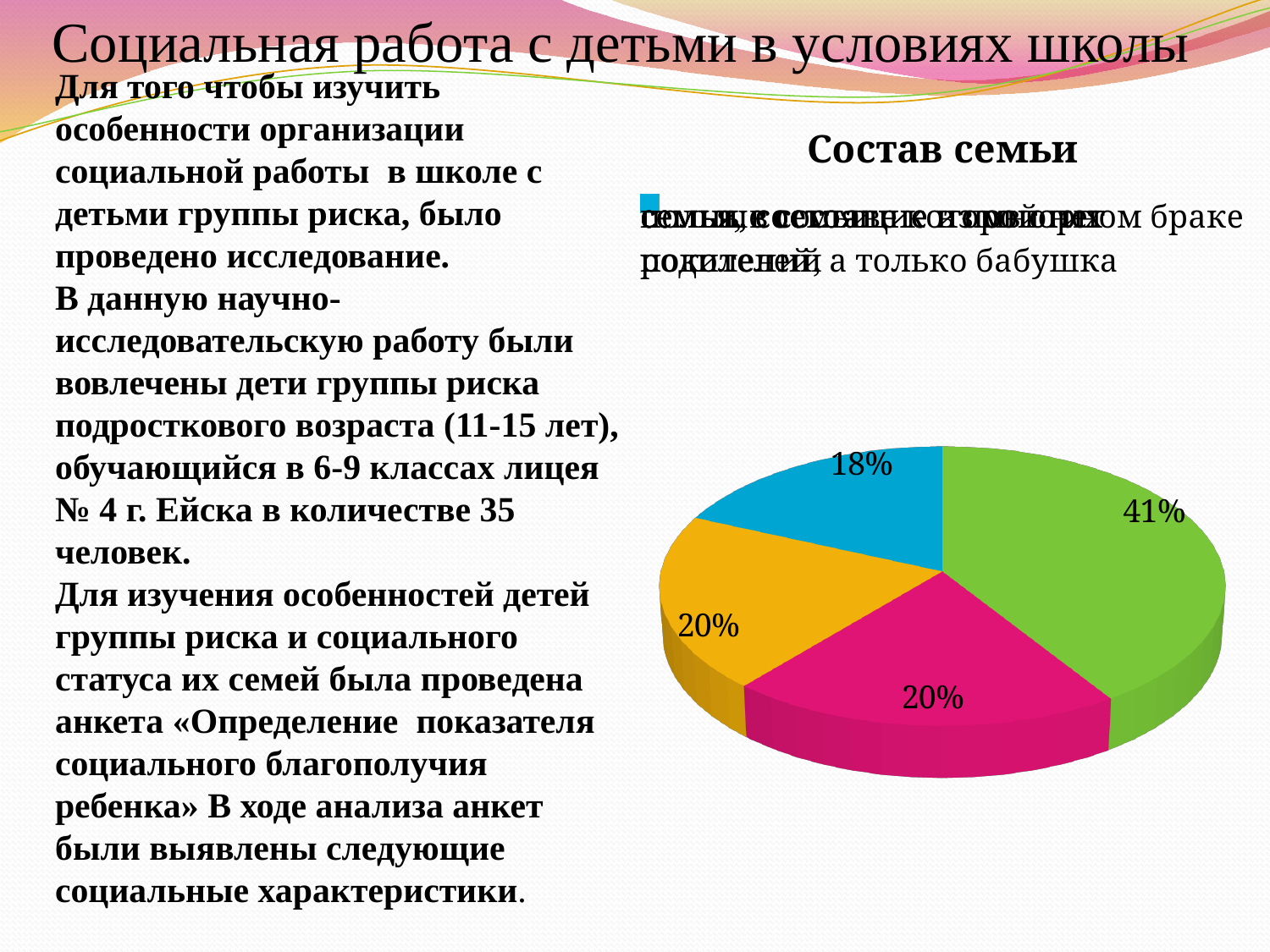
Which colour slice is the smallest in the pie chart? blue What percentage is shown for the blue slice of the pie chart? 18% What is the difference in percentage points between the green slice and the blue slice? 23 What share of the pie does the blue slice represent? 18% Which is larger, the green slice or the yellow slice? green How many slices does the pie chart have? 4 Which colour slice is the largest in the pie chart? green What percentage is shown for the green slice of the pie chart? 41% What percentage is shown for the yellow slice of the pie chart? 20% What is the title of the chart on the slide? Состав семьи What kind of chart is shown on the slide? pie chart What percentage is shown for the magenta slice of the pie chart? 20%